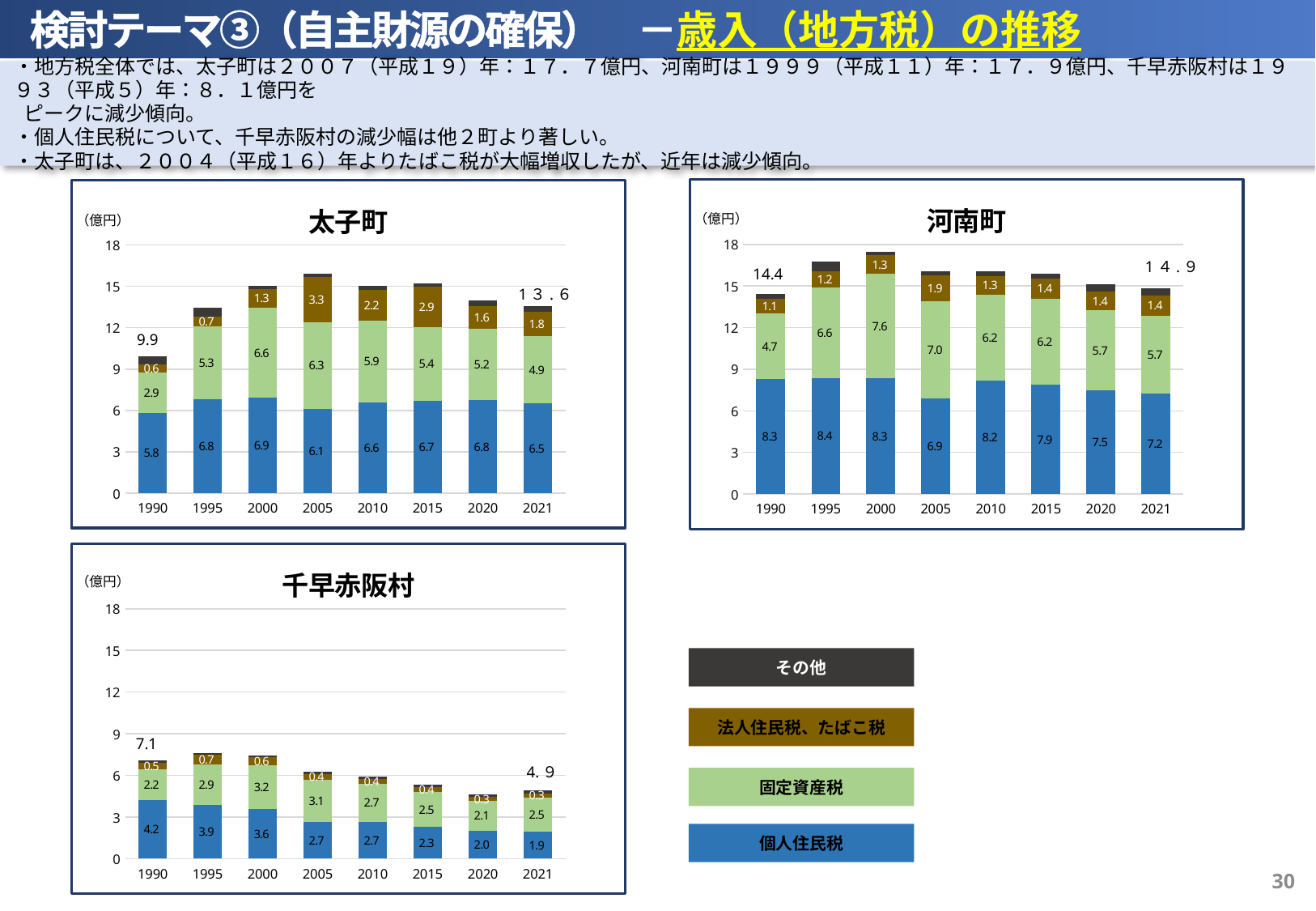
In the 河南町 chart, what is the 固定資産税 value for 2000? 7.6 In the 河南町 chart, which year has the lowest 個人住民税 value? 2005 In the 太子町 chart, which year has the highest 個人住民税 value? 2000 In the 河南町 chart, is the total for 2000 greater or less than 15? greater How many series does the legend on the slide list? 4 In the 千早赤阪村 chart, does the 個人住民税 value rise or fall from 1990 to 2021? Fall What kind of chart is the 太子町 chart? Stacked bar chart Which is larger for 2021: the 固定資産税 value in the 河南町 chart or in the 太子町 chart? 河南町 In the 千早赤阪村 chart, how many years are shown on the x axis? 8 In the 千早赤阪村 chart, what is the difference between the 個人住民税 values for 1990 and 2021? 2.3 In the 太子町 chart, what is the 法人住民税、たばこ税 value for 2005? 3.3 In the 太子町 chart, what is the total labelled for the 1990 bar? 9.9